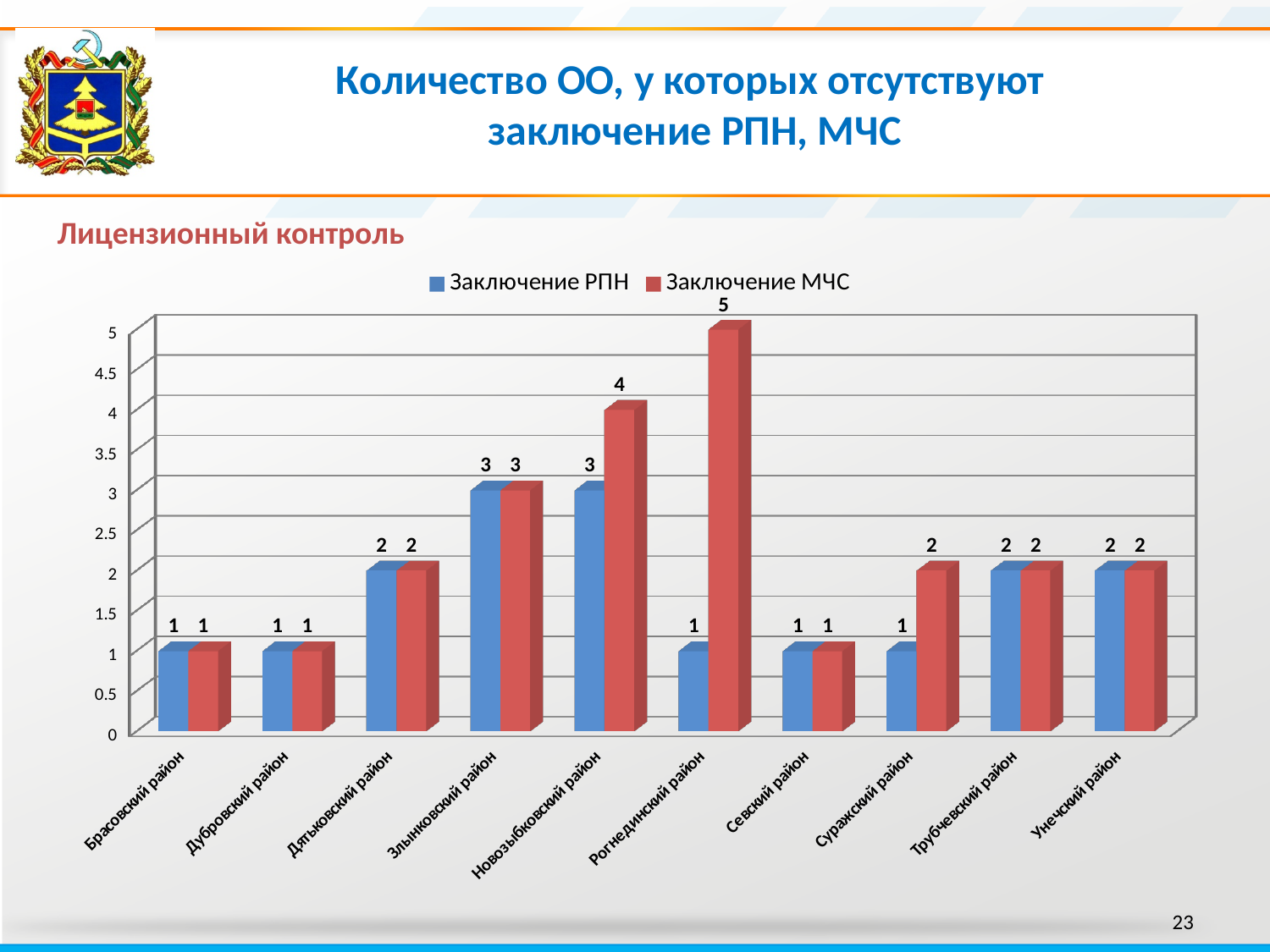
Which district has the highest value for Заключение МЧС? Рогнединский район How many districts are shown on the x axis of the chart? 10 How many series does the chart legend list? 2 What is the value of Заключение МЧС for Рогнединский район? 5 For Суражский район, which is larger: Заключение РПН or Заключение МЧС? Заключение МЧС What is the value of Заключение РПН for Новозыбковский район? 3 What is the value of Заключение МЧС for Суражский район? 2 What type of chart is shown on the slide? Bar chart What is the value of Заключение РПН for Злынковский район? 3 What is the difference between Заключение МЧС and Заключение РПН for Рогнединский район? 4 Which is larger: Заключение МЧС for Рогнединский район or Заключение МЧС for Новозыбковский район? Рогнединский район What is the difference between Заключение МЧС and Заключение РПН for Новозыбковский район? 1